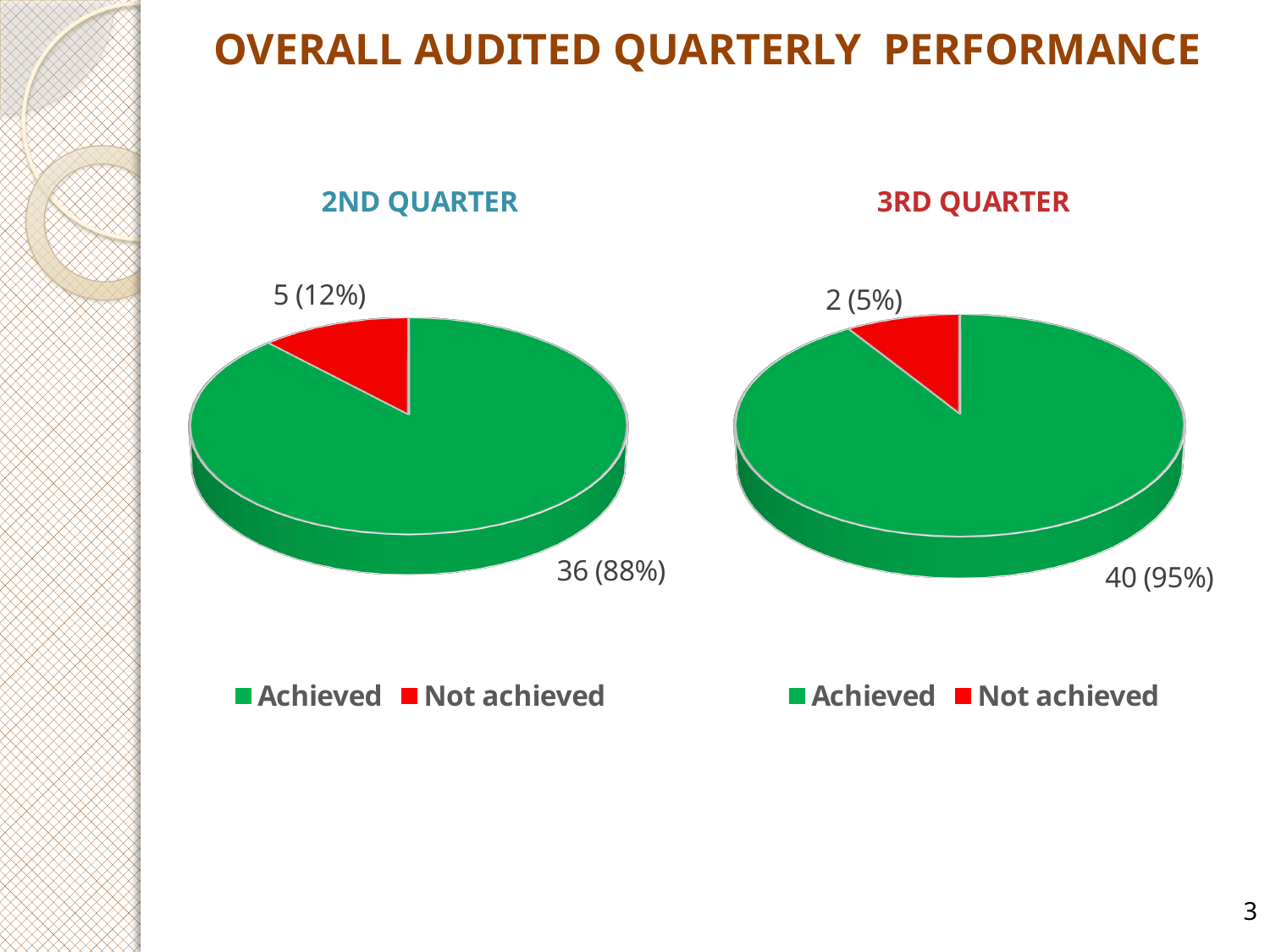
In the 3RD QUARTER chart, what is the value for Achieved? 40 (95%) In the 2ND QUARTER chart, what is the value for Achieved? 36 (88%) In the 2ND QUARTER chart, what share of the pie does Not achieved represent? 12% In the 3RD QUARTER chart, what share of the pie does Achieved represent? 95% In the 2ND QUARTER chart, what is the value for Not achieved? 5 (12%) In the 3RD QUARTER chart, which category is the smallest? Not achieved What is the difference between the Achieved count in the 3RD QUARTER chart and the Achieved count in the 2ND QUARTER chart? 4 In the 2ND QUARTER chart, which category is the largest? Achieved What type of chart is the 3RD QUARTER chart? Pie chart How many categories does the legend of the 2ND QUARTER chart list? 2 In the 3RD QUARTER chart, what is the value for Not achieved? 2 (5%) Which is larger: the Not achieved count in the 2ND QUARTER chart or in the 3RD QUARTER chart? 2ND QUARTER